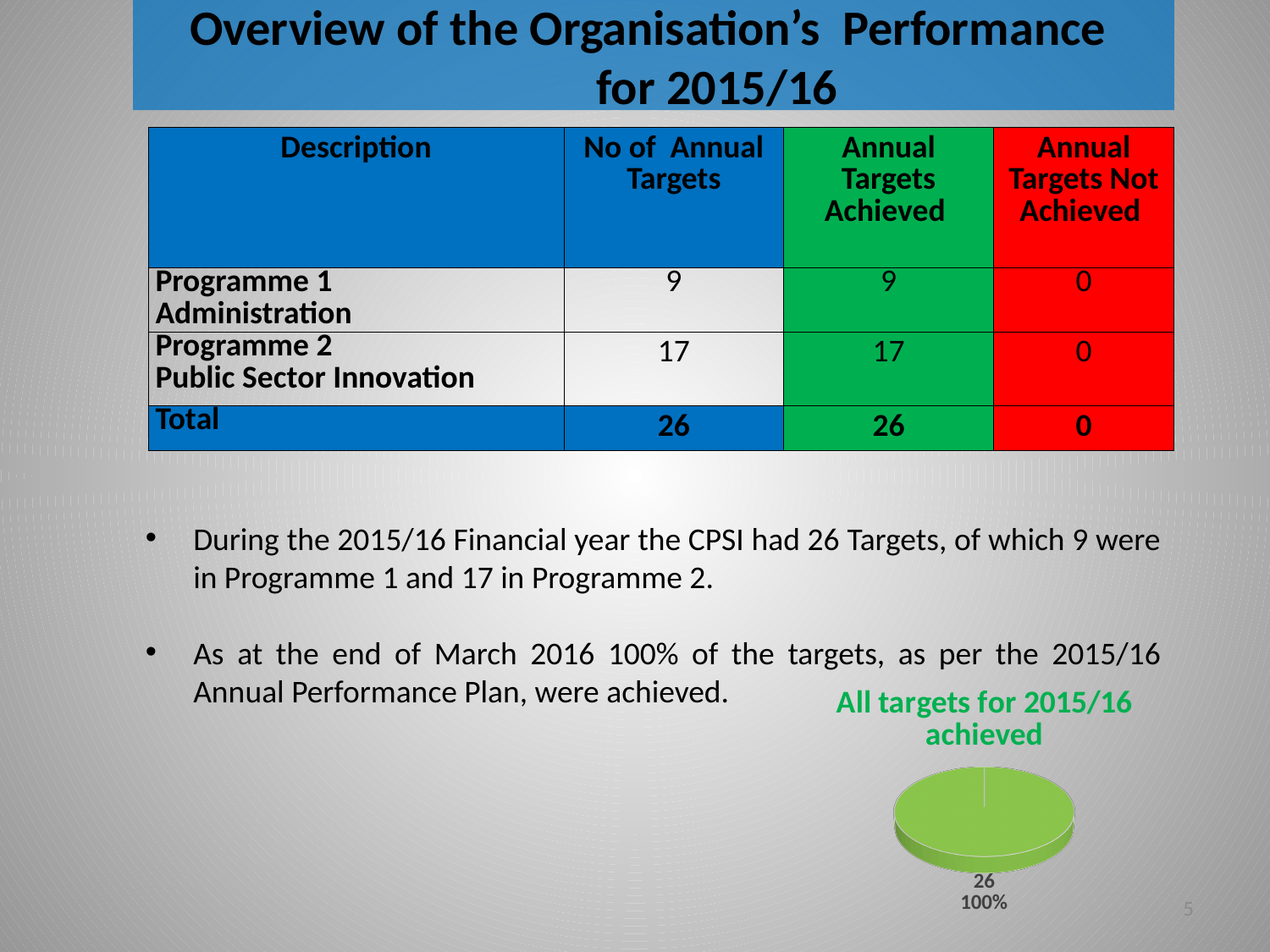
How many slices does the pie chart contain? 1 What kind of chart is shown at the bottom right of the slide? Pie chart What colour is the slice in the pie chart? Green What value is printed on the data label of the pie chart? 26 What percentage share is shown on the pie chart's data label? 100% What is the title of the pie chart on the slide? All targets for 2015/16 achieved